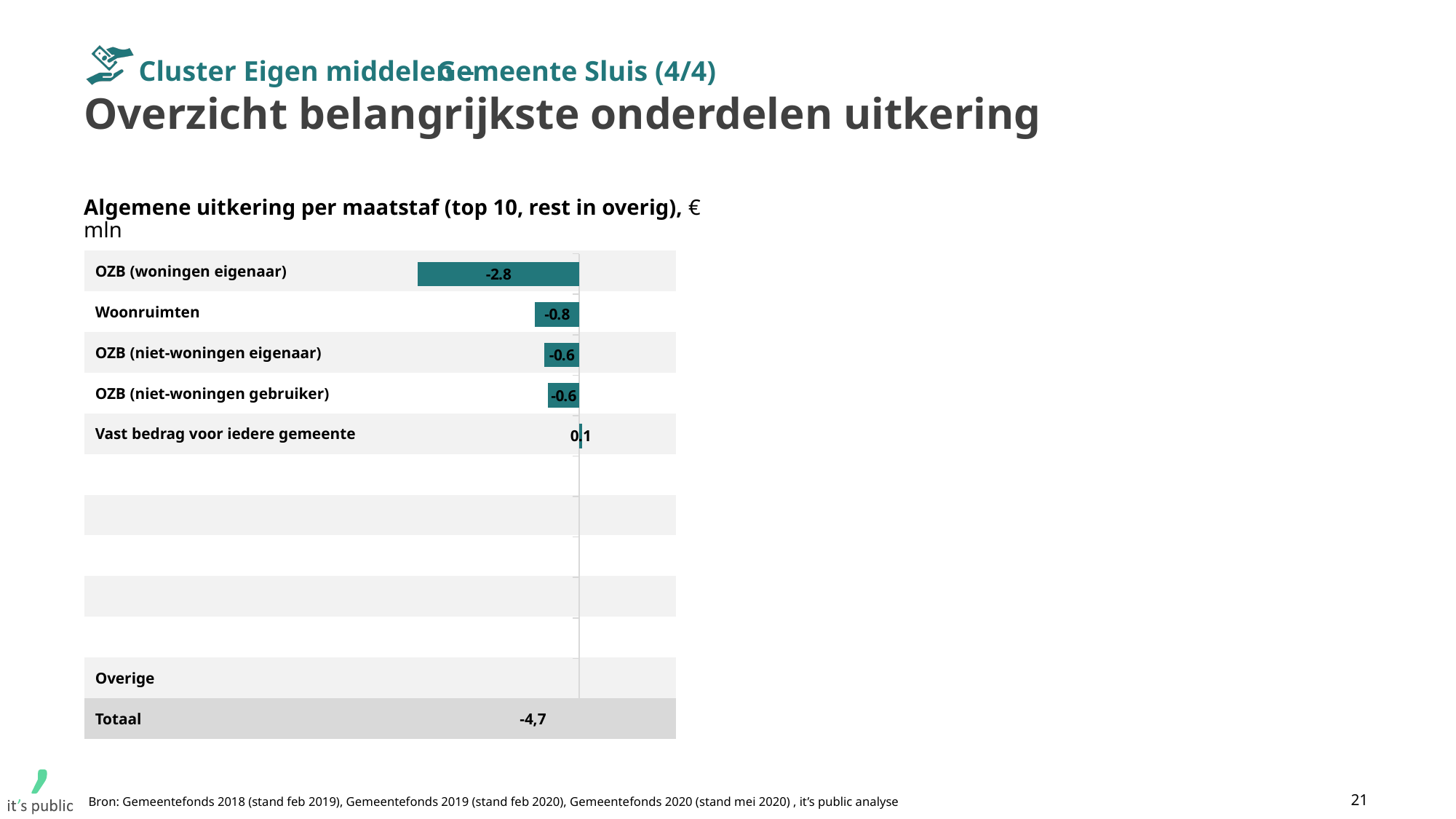
What is the value for Woonruimten? -0.8 By how much is the value for OZB (woningen eigenaar) lower than the value for Woonruimten? 2.0 What is the value shown for Totaal? -4,7 How many named categories, excluding Overige and Totaal, have a bar plotted? 5 Which category has the highest value? Vast bedrag voor iedere gemeente What is the title of the chart? Algemene uitkering per maatstaf (top 10, rest in overig), € mln Which category has the lowest (most negative) value? OZB (woningen eigenaar) What is the value for OZB (woningen eigenaar)? -2.8 What kind of chart is shown on the slide? Bar chart Which has the larger (less negative) value, Woonruimten or OZB (woningen eigenaar)? Woonruimten What is the value for OZB (niet-woningen eigenaar)? -0.6 What is the value for OZB (niet-woningen gebruiker)? -0.6